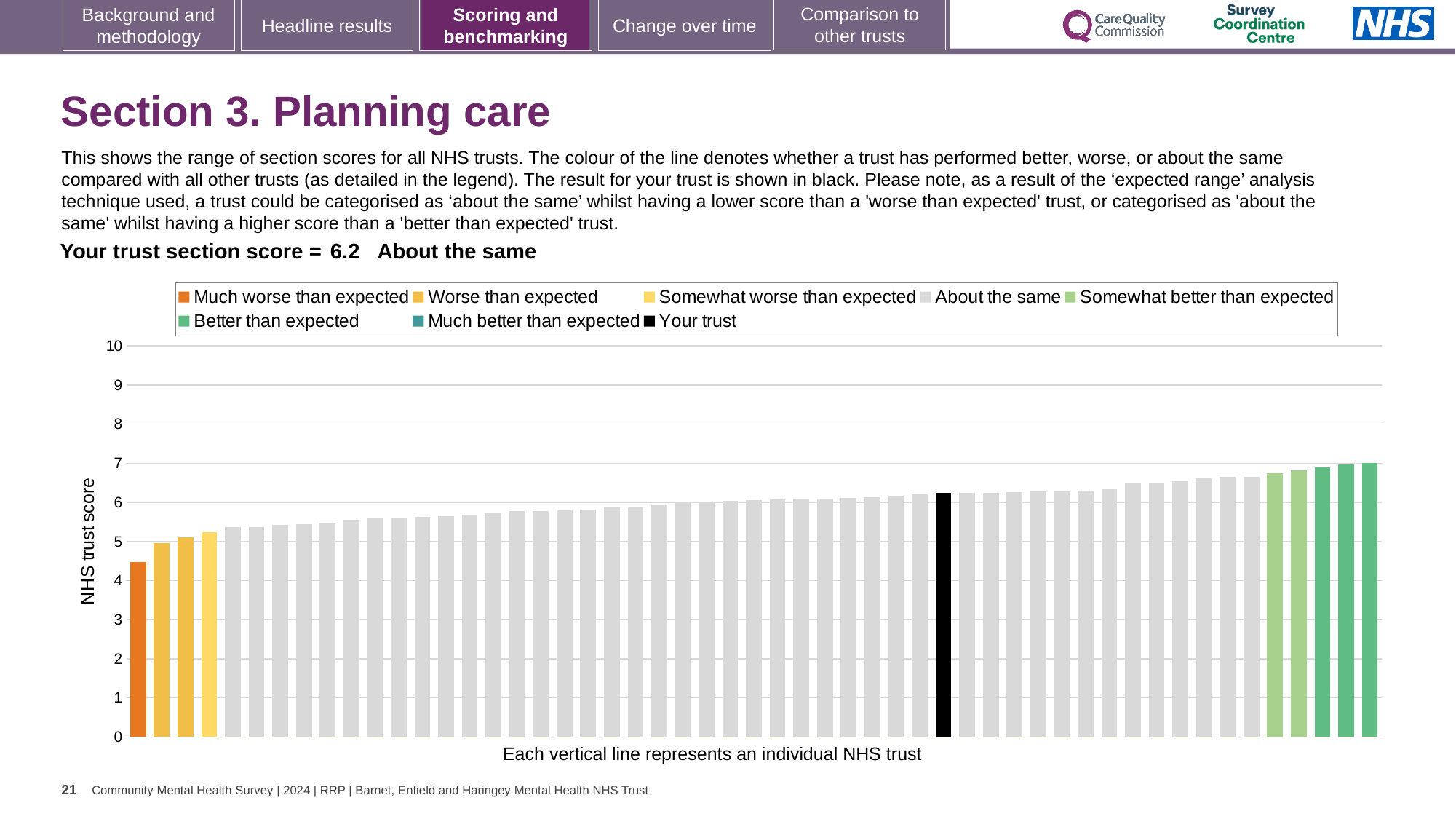
What is the label on the vertical axis of the chart? NHS trust score Which category is your trust's section score placed in? About the same Is the value for your trust greater or less than 6? greater How many entries does the chart legend list? 8 What is the section score for your trust? 6.2 What colour is the bar representing your trust? black Do the bar values rise or fall from left to right along the x axis? rise What kind of chart is shown on the slide? bar chart Is the value of the leftmost (orange) bar greater or less than 5? less Is the value of the tallest bar greater or less than 8? less Which is larger: the bar for your trust or the leftmost orange bar? your trust